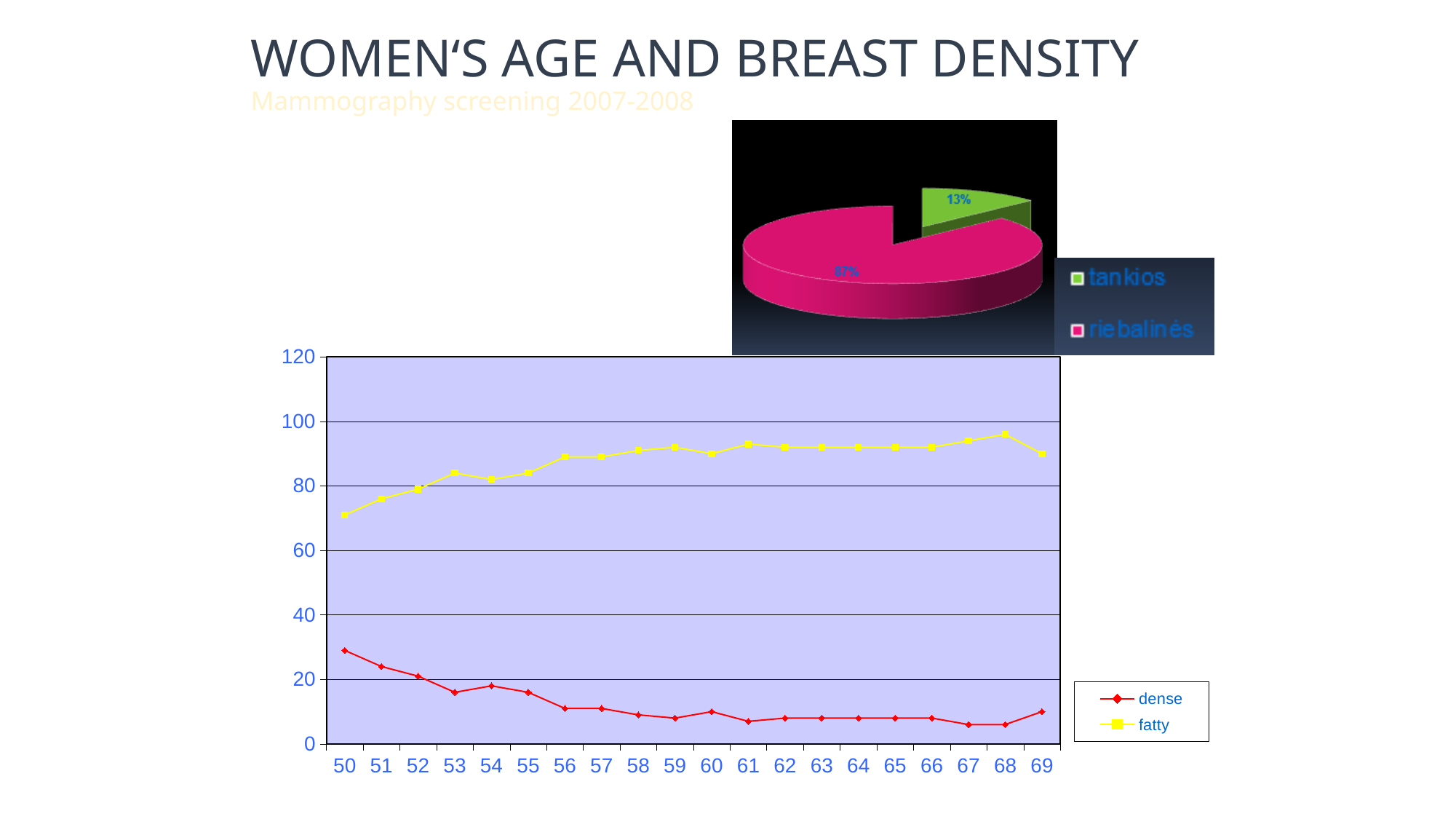
In the top-right pie chart, what share does the 'tankios' slice have? 13% In the bottom line chart, is the value for 'fatty' at age 68 greater or less than 80? greater In the bottom line chart, is the value for 'fatty' at age 50 greater or less than 60? greater In the bottom line chart, how many series does the legend list? 2 In the bottom line chart, does the 'fatty' series rise or fall as age increases from 50 to 69? rise In the bottom line chart, is the value for 'dense' at age 61 greater or less than 20? less What kind of chart is the chart at the bottom of the slide? line chart In the bottom line chart, how many age categories are shown on the x axis? 20 In the top-right pie chart, which slice is larger, 'tankios' or 'riebalinės'? riebalinės In the bottom line chart, does the 'dense' series rise or fall as age increases from 50 to 69? fall What kind of chart is the chart at the top right of the slide? pie chart In the bottom line chart, at which age is the 'dense' series highest? 50